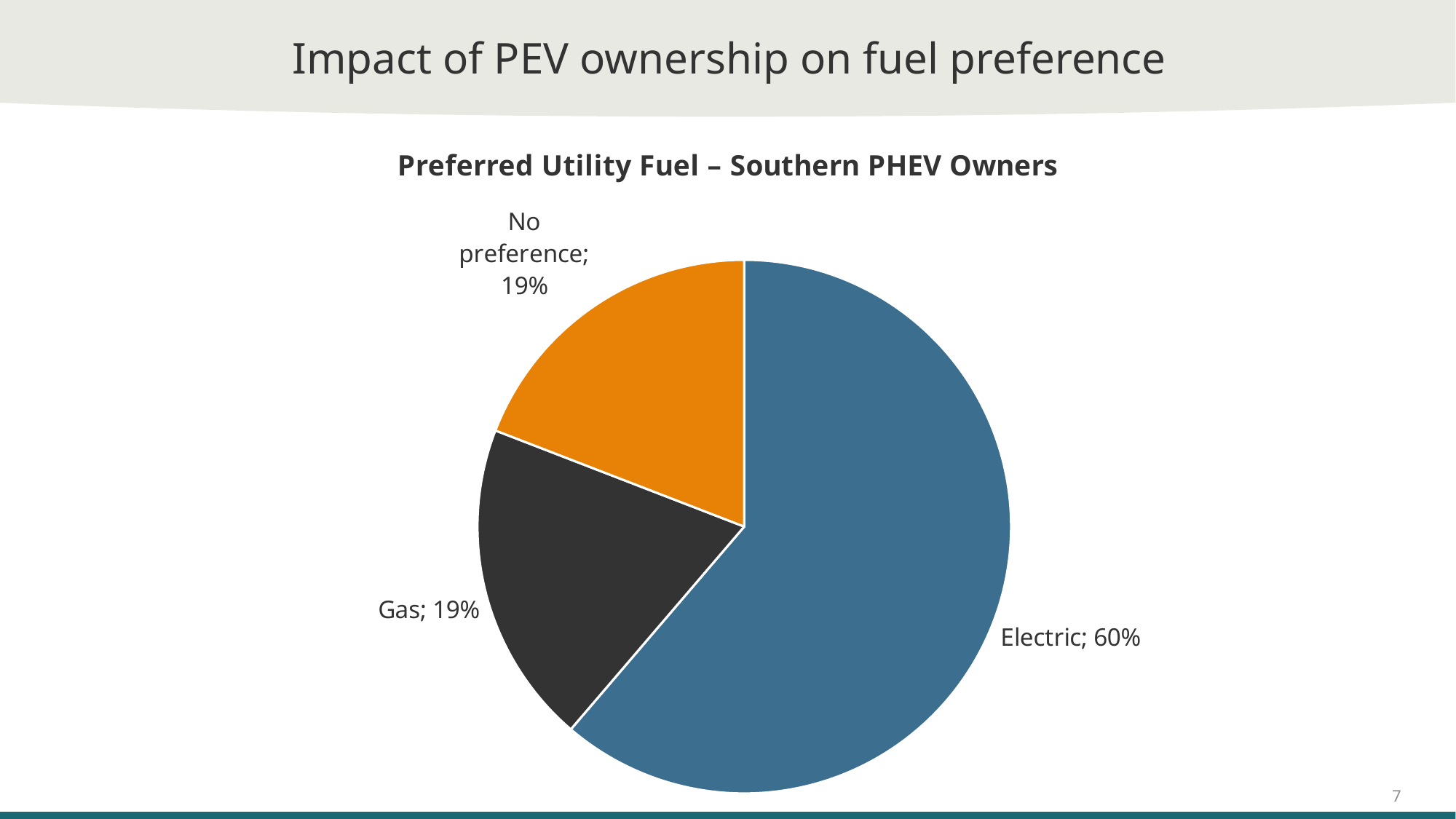
Which category has the largest slice of the pie? Electric What share of Southern PHEV owners have No preference? 19% What share of Southern PHEV owners prefer Gas? 19% Which is larger, the Electric slice or the No preference slice? Electric What is the difference between the Electric share and the Gas share? 41% What colour is the Electric slice? blue What is the chart's title? Preferred Utility Fuel – Southern PHEV Owners What type of chart is shown on the slide? pie chart What is the combined share of Gas and No preference? 38% How many slices does the pie chart have? 3 What share of Southern PHEV owners prefer Electric? 60%